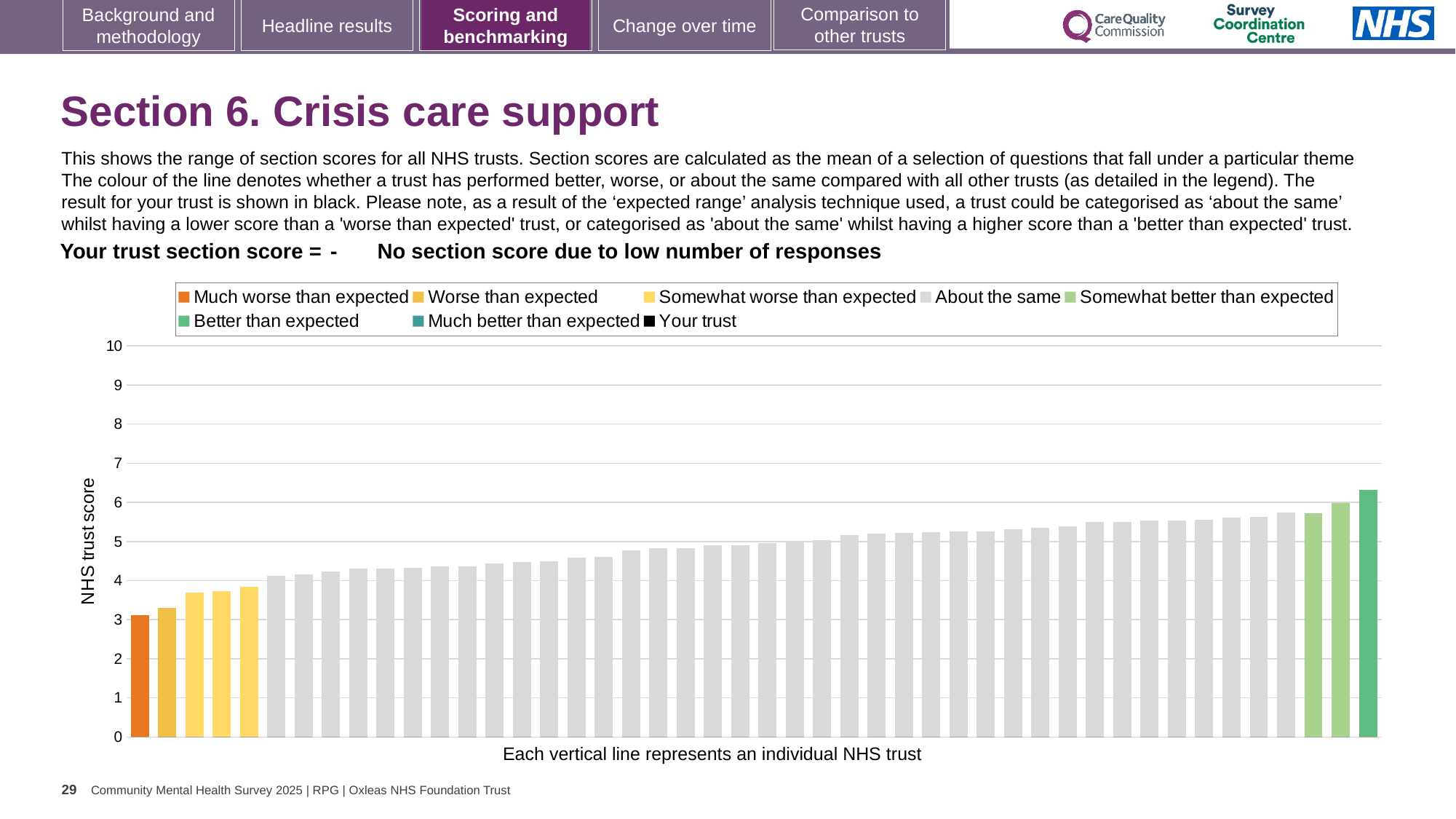
How many bars are coloured as 'Much better than expected'? 0 Do the bar values rise or fall from left to right along the x axis? Rise Is the value of the shortest bar greater or less than 4? less How many bars are coloured as 'Somewhat worse than expected'? 3 What kind of chart is shown on the slide? Bar chart Which legend category does the tallest bar belong to? Better than expected What is the label on the vertical axis of the chart? NHS trust score Is the value of the tallest bar greater or less than 6? greater How many bars are coloured as 'Somewhat better than expected'? 2 Is the value of the tallest bar greater or less than 7? less How many entries does the chart legend list? 8 Which legend category does the shortest bar belong to? Much worse than expected